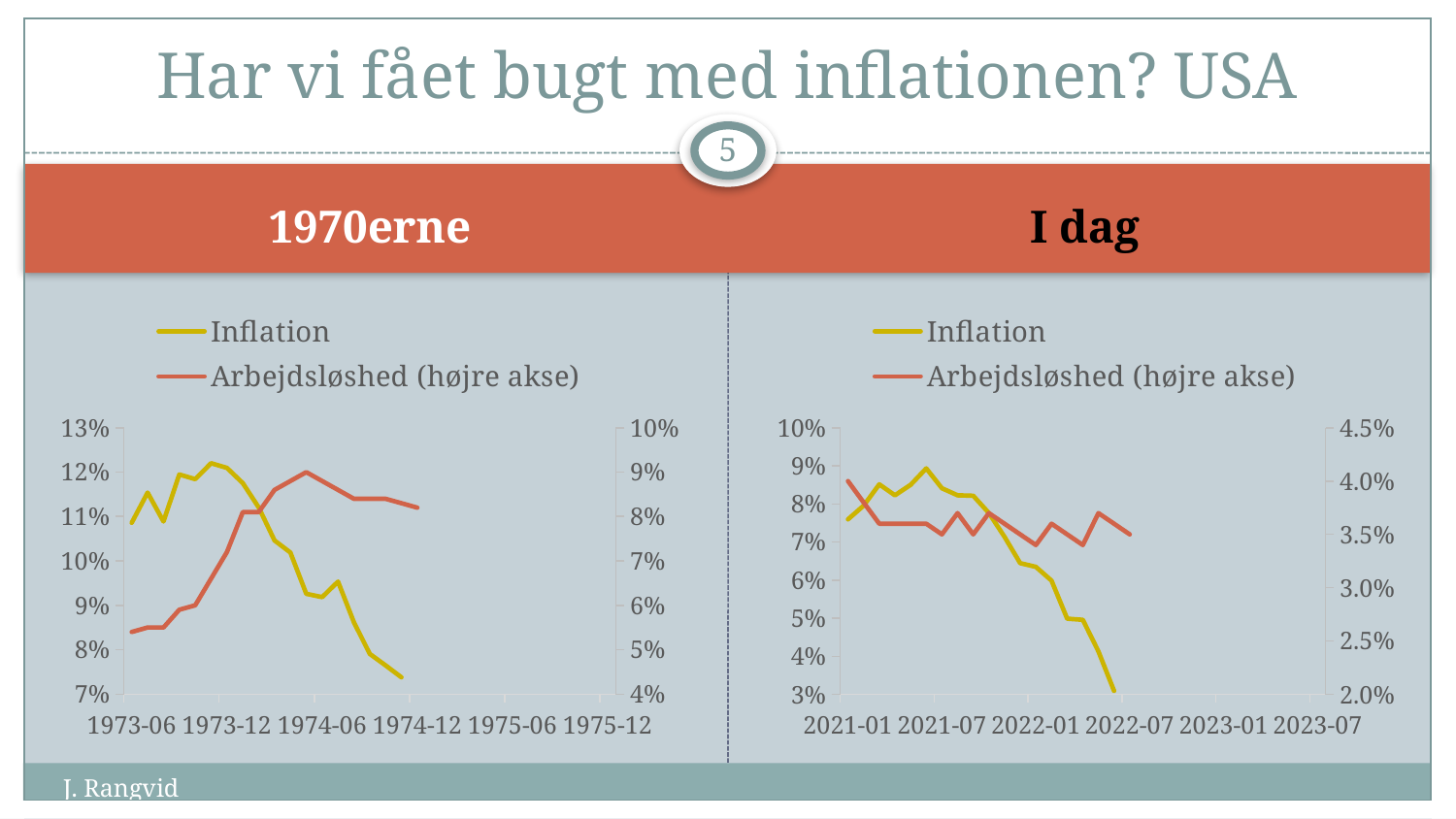
In the '1970erne' chart, is the Inflation value at 1974-12 greater or less than 8%? less In the '1970erne' chart, does the Arbejdsløshed line rise or fall overall from 1973-06 to 1974-12? rise What is the highest tick on the right-hand axis of the 'I dag' chart? 4.5% In the '1970erne' chart, is the Arbejdsløshed value at 1973-06 greater or less than 6%? less In the 'I dag' chart, is the Arbejdsløshed value at 2021-01 greater or less than 3.5%? greater How many series does the legend of the 'I dag' chart list? 2 What kind of chart is the '1970erne' chart? line chart In the '1970erne' chart, which series is plotted on the right axis? Arbejdsløshed In the 'I dag' chart, does the Inflation line rise or fall overall from 2021-01 to 2022-07? fall In the '1970erne' chart, which series is drawn in yellow? Inflation